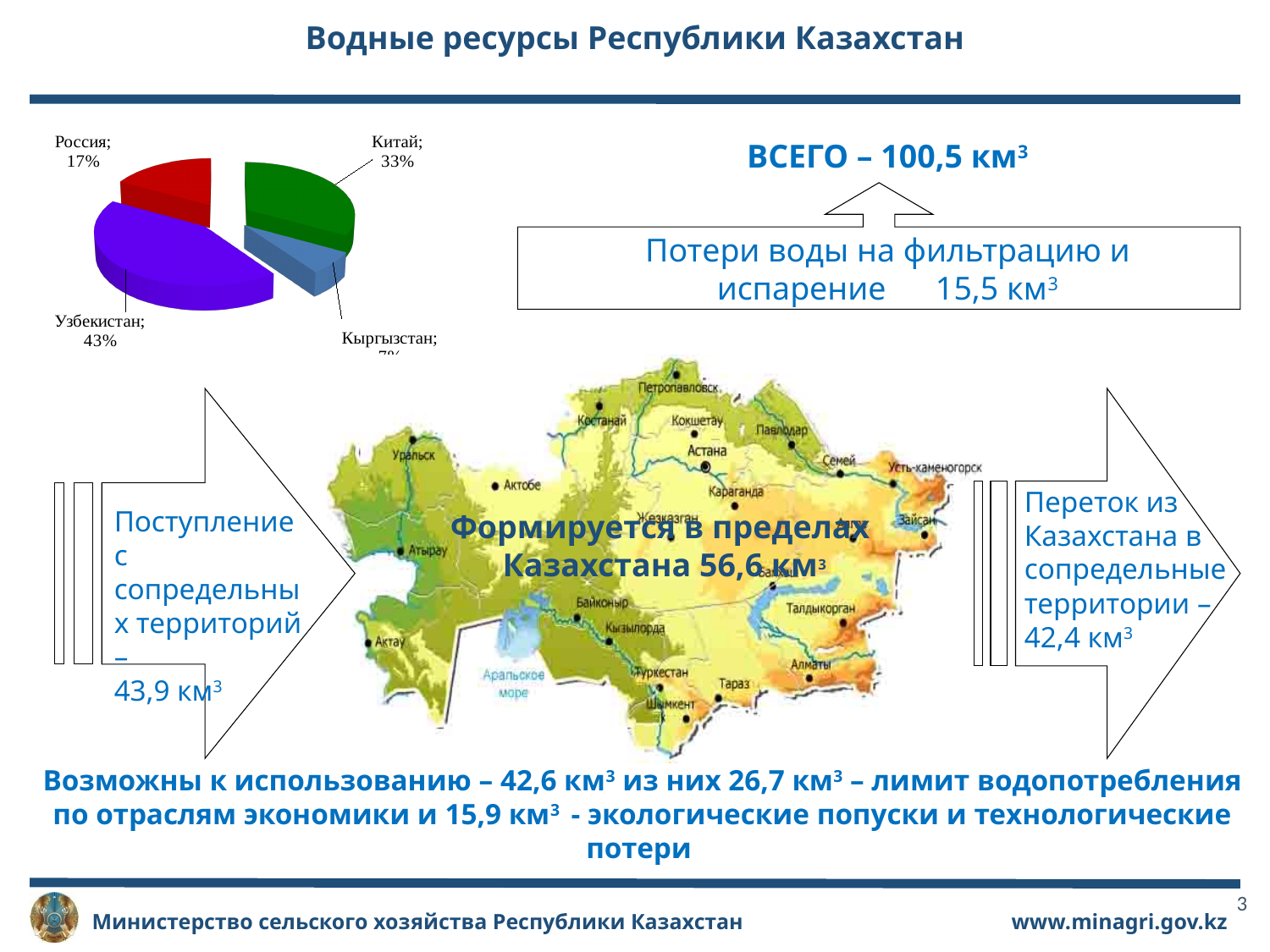
What colour is the Китай slice in the pie chart? Green Which country has the largest slice in the pie chart? Узбекистан What type of chart is shown on the slide? Pie chart Which slice is larger in the pie chart, Китай or Россия? Китай How many countries are shown as slices in the pie chart? 4 What colour is the Узбекистан slice in the pie chart? Purple What share of the pie chart does Россия account for? 17% What share of the pie chart does Китай account for? 33% By how many percentage points does the Узбекистан share exceed the Россия share in the pie chart? 26 percentage points Which country has the smallest slice in the pie chart? Кыргызстан By how many percentage points does the Узбекистан share exceed the Китай share in the pie chart? 10 percentage points What share of the pie chart does Узбекистан account for? 43%